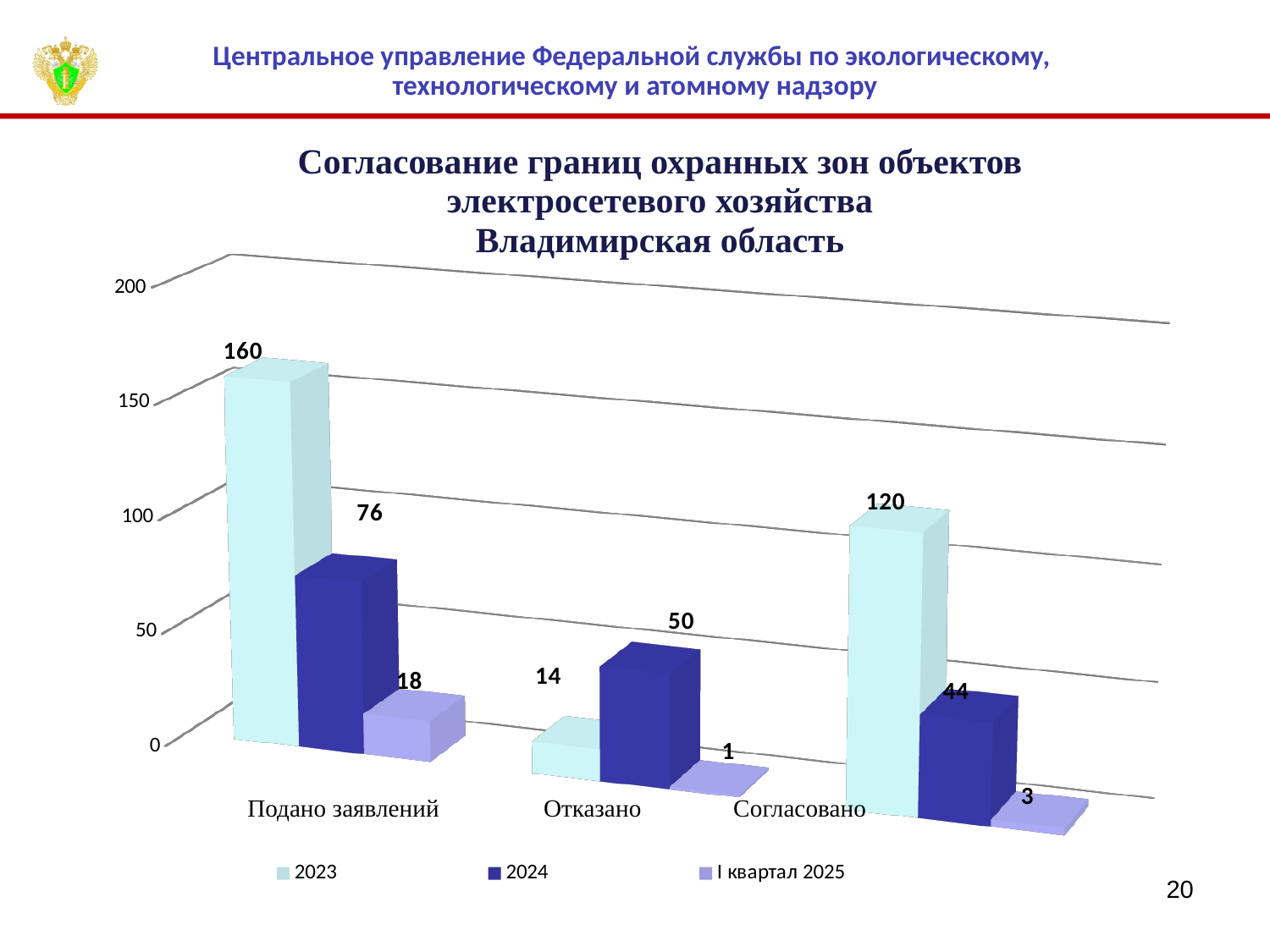
Which is larger in the category Отказано: the value for 2023 or the value for 2024? 2024 What is the value for 2023 in the category Подано заявлений? 160 What is the difference between the 2023 and 2024 values in the category Согласовано? 76 Which category has the highest value for the 2024 series? Подано заявлений What is the value for 2024 in the category Отказано? 50 What is the value for I квартал 2025 in the category Согласовано? 3 How many series does the legend list? 3 Which category has the lowest value for the 2023 series? Отказано What kind of chart is shown on the slide? bar chart Which region is named in the chart title? Владимирская область Is the value for 2023 in the category Согласовано greater or less than 100? greater How many categories are shown on the x axis? 3